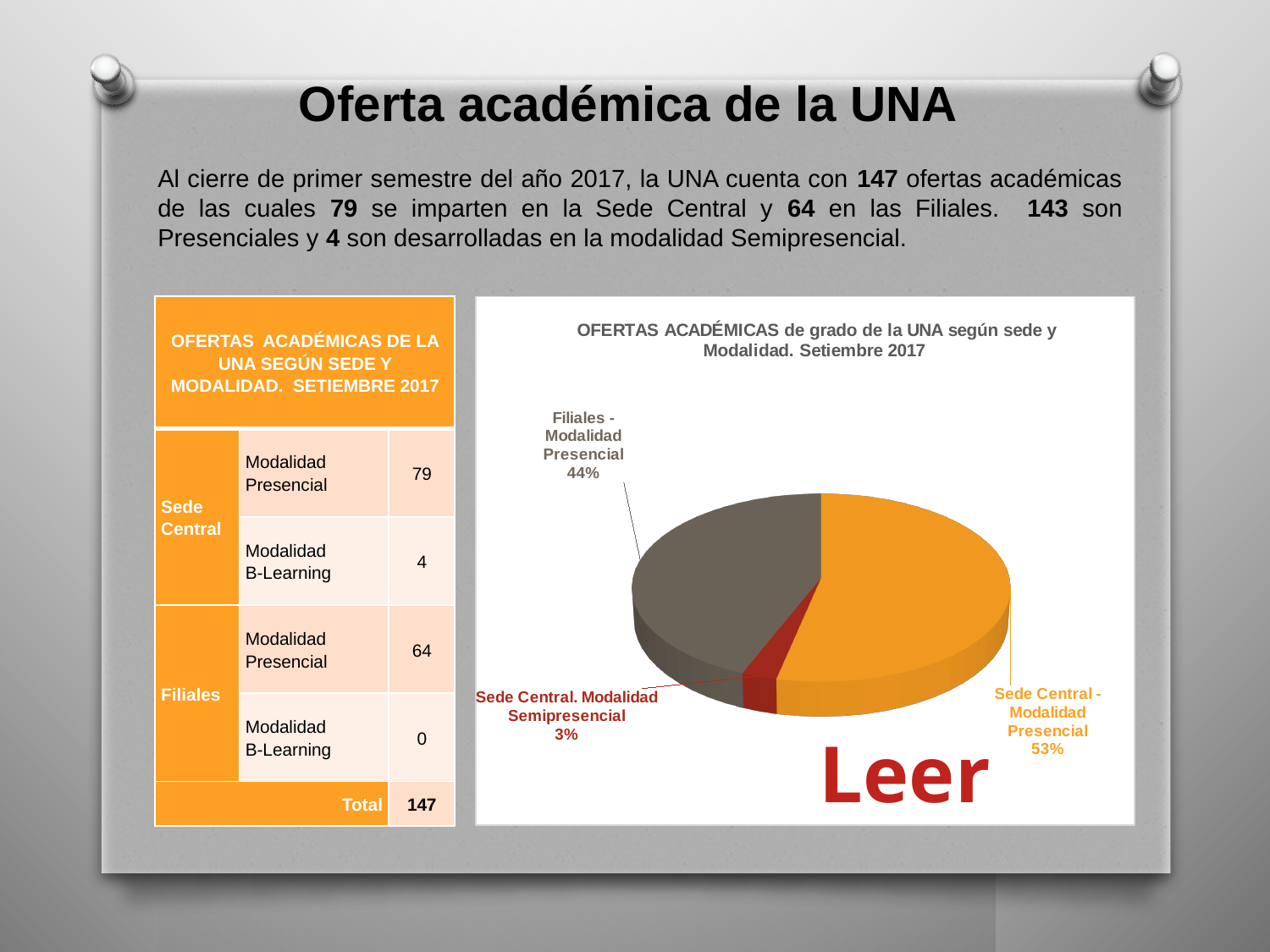
What share of the pie does the slice 'Filiales - Modalidad Presencial' represent? 44% Which slice of the pie chart is the smallest? Sede Central. Modalidad Semipresencial What percentage is shown for 'Sede Central. Modalidad Semipresencial'? 3% What is the title of the pie chart? OFERTAS ACADÉMICAS de grado de la UNA según sede y Modalidad. Setiembre 2017 What colour is the 'Sede Central - Modalidad Presencial' slice in the pie chart? orange What is the difference in percentage points between 'Sede Central - Modalidad Presencial' and 'Filiales - Modalidad Presencial'? 9 How many slices does the pie chart have? 3 Which slice of the pie chart is the largest? Sede Central - Modalidad Presencial What kind of chart is shown on the slide? pie chart Which is larger: the share for 'Filiales - Modalidad Presencial' or the share for 'Sede Central. Modalidad Semipresencial'? Filiales - Modalidad Presencial What share of the pie does the slice 'Sede Central - Modalidad Presencial' represent? 53%